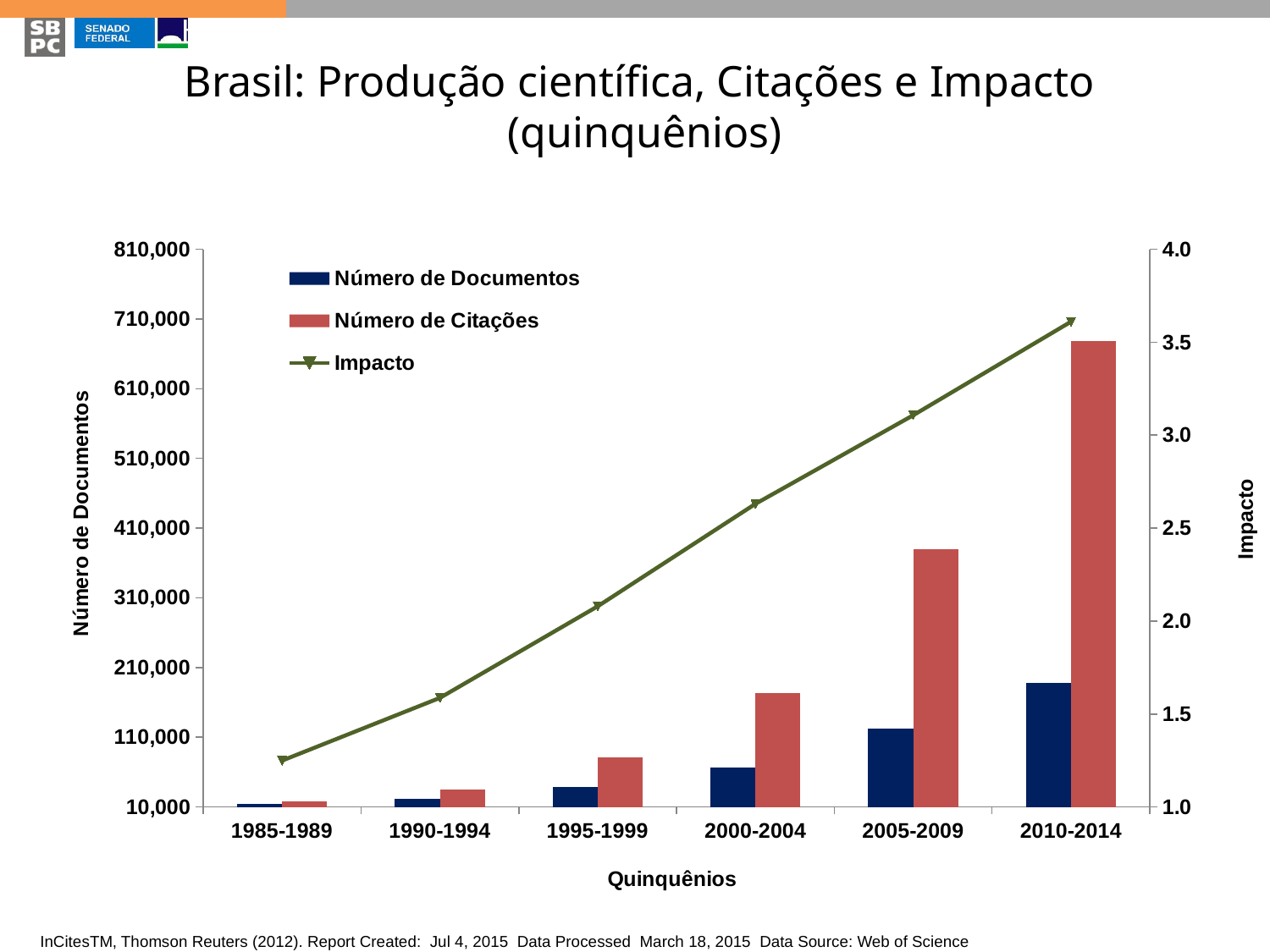
Is the Número de Citações value for 2010-2014 greater or less than 610,000? greater In which period is Número de Citações highest? 2010-2014 In 2010-2014, which is larger: Número de Documentos or Número de Citações? Número de Citações In which period is Número de Documentos lowest? 1985-1989 Is the Número de Documentos value for 2010-2014 greater or less than 210,000? less What kind of chart is used for the Número de Documentos and Número de Citações series? Bar chart What is the label of the right-hand vertical axis? Impacto Is the Impacto value for 2010-2014 greater or less than 3.5? greater How many series does the chart's legend list? 3 How many quinquênios (periods) are shown on the x axis of the chart? 6 Does the Impacto line rise or fall from 1985-1989 to 2010-2014? Rises